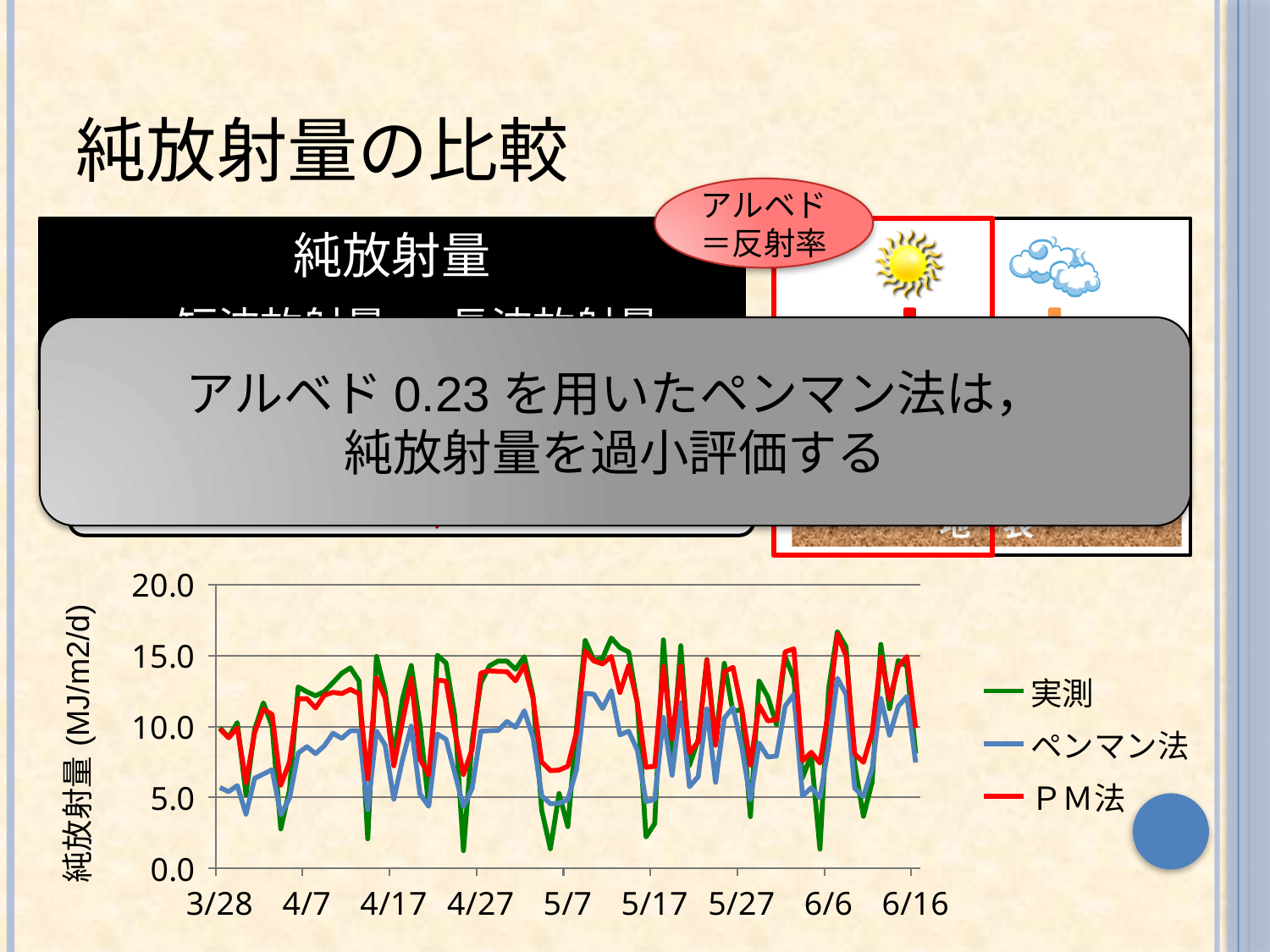
What are the three series listed in the chart's legend? 実測, ペンマン法, ＰＭ法 How many series does the chart's legend list? 3 On 3/28, which series has the larger value, ペンマン法 or ＰＭ法? ＰＭ法 Is the highest value reached by ペンマン法 greater or less than 15.0? less Is the value for ペンマン法 on 3/28 greater or less than 10.0? less What is the label of the chart's vertical axis? 純放射量 (MJ/m2/d) How many date labels are shown along the chart's x axis? 9 What is the first date label on the chart's x axis? 3/28 Which series has the lowest values across most of the period shown? ペンマン法 Is the highest value reached by 実測 greater or less than 15.0? greater What kind of chart is shown on the slide? line chart